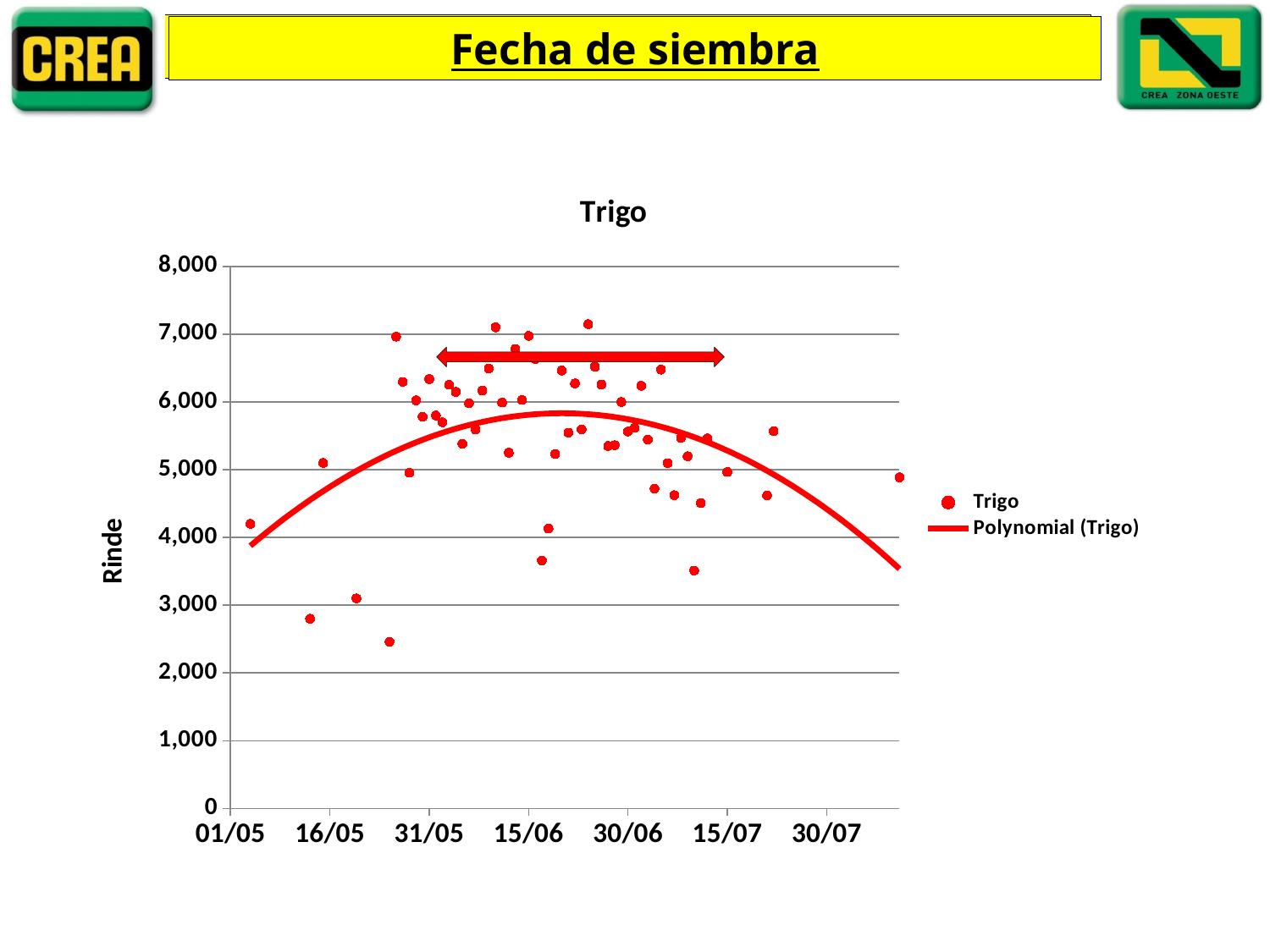
Is the value of the Polynomial (Trigo) trendline at its right-hand end greater or less than 4,000? less How many series does the legend list? 2 Is the peak of the Polynomial (Trigo) trendline greater or less than 5,000? greater What is the title of the chart? Trigo Is the lowest plotted Trigo point greater or less than 3,000? less Does the Polynomial (Trigo) trendline rise or fall between 15/07 and 30/07? fall Does the Polynomial (Trigo) trendline rise or fall between 01/05 and 31/05? rise What kind of chart is shown on the slide? scatter chart What is the label on the vertical axis of the chart? Rinde